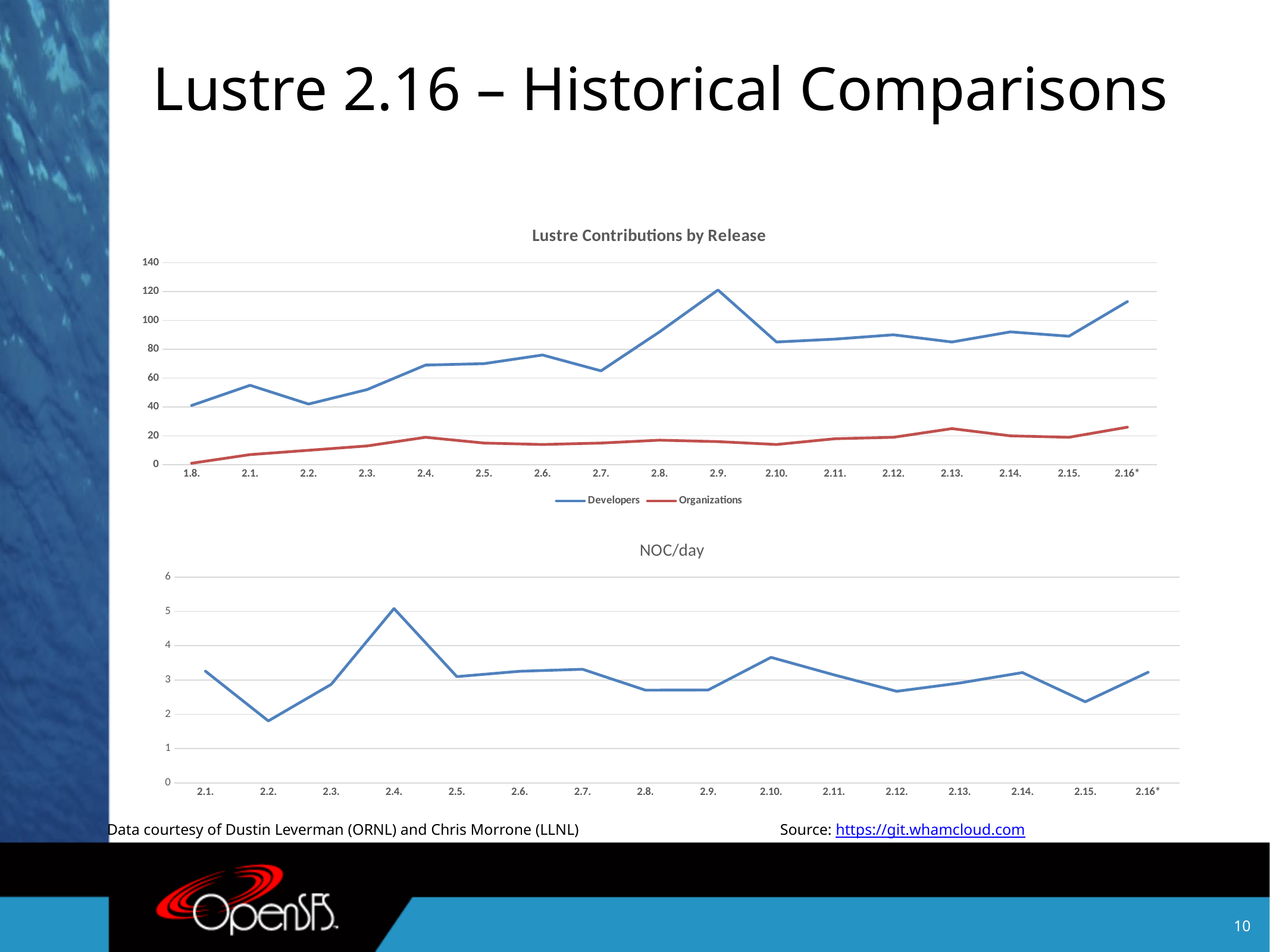
In the 'Lustre Contributions by Release' chart, which is larger, the Developers value for 2.9. or for 2.10.? 2.9. In the 'Lustre Contributions by Release' chart, how many series does the legend list? 2 In the 'NOC/day' chart, at which release is the value highest? 2.4. In the 'Lustre Contributions by Release' chart, what are the two series named in the legend? Developers and Organizations In the 'NOC/day' chart, at which release is the value lowest? 2.2. In the 'Lustre Contributions by Release' chart, is the Organizations value for 2.16* greater or less than 20? greater In the 'Lustre Contributions by Release' chart, is the Developers value for 2.9. greater or less than 100? greater In the 'Lustre Contributions by Release' chart, how many releases are shown on the x axis? 17 In the 'Lustre Contributions by Release' chart, at which release is the Organizations value lowest? 1.8. In the 'Lustre Contributions by Release' chart, at which release is the Developers value highest? 2.9. In the 'NOC/day' chart, is the value for 2.15. greater or less than 3? less In the 'Lustre Contributions by Release' chart, what kind of chart is shown? line chart